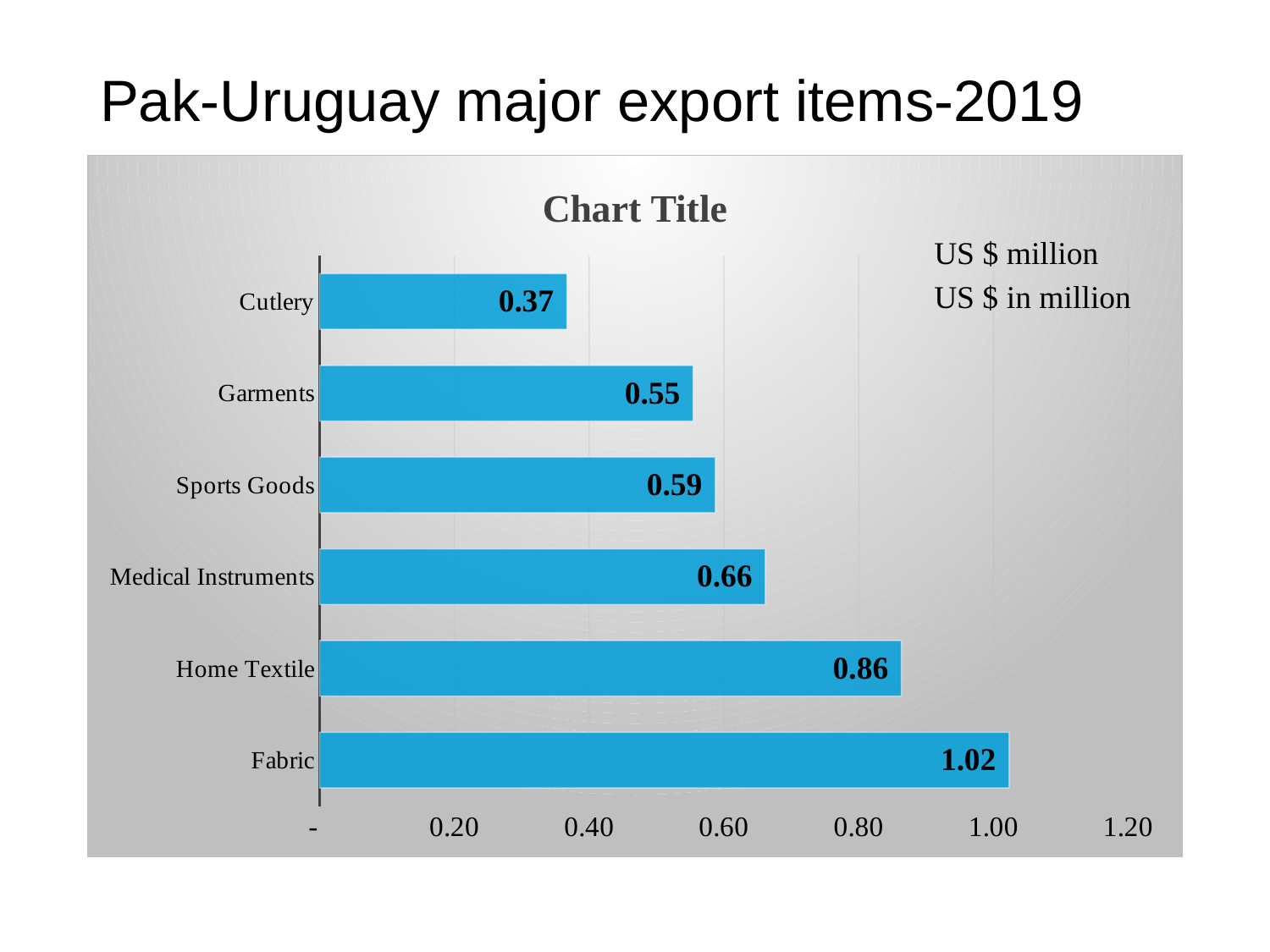
What is the value for Fabric? 1.02 What is the value for Medical Instruments? 0.66 How many categories are shown in the chart? 6 What is the value for Home Textile? 0.86 What is the value for Cutlery? 0.37 Which category has the highest value? Fabric What kind of chart is shown on the slide? Bar chart What is the difference between the values for Garments and Cutlery? 0.18 Which category has the lowest value? Cutlery Which is larger, the value for Sports Goods or the value for Garments? Sports Goods What is the difference between the values for Fabric and Home Textile? 0.16 Is the value for Medical Instruments greater or less than 0.60? greater